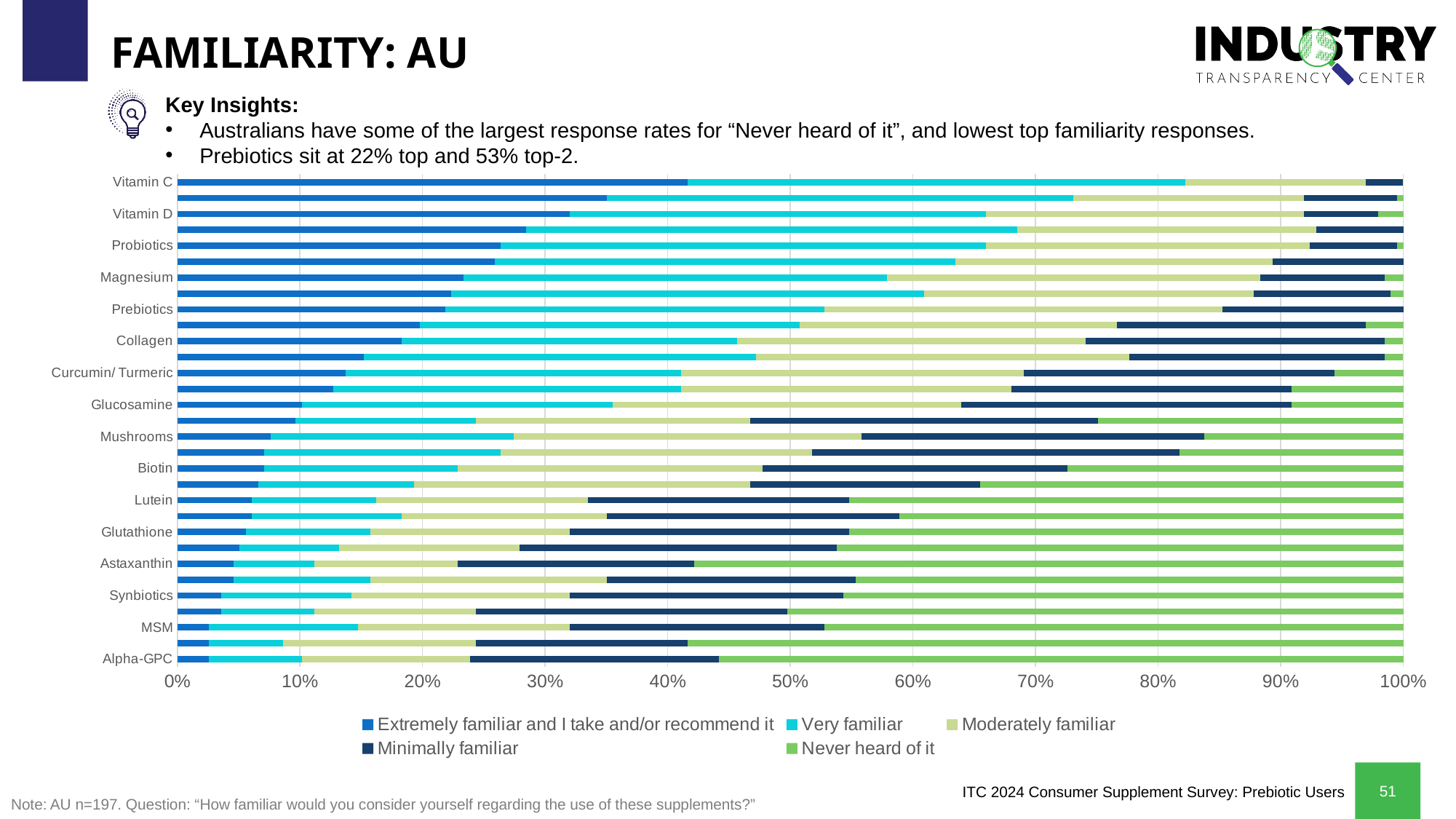
Which labelled supplement has the largest 'Never heard of it' share? Astaxanthin According to the Key Insights text, what is the top familiarity response rate for Prebiotics? 22% Is the 'Extremely familiar and I take and/or recommend it' value for Vitamin C greater or less than 30%? greater What kind of chart is shown on the slide? Stacked bar chart Is the 'Extremely familiar and I take and/or recommend it' value for Glucosamine greater or less than 20%? less Which has a larger 'Extremely familiar and I take and/or recommend it' share, Vitamin C or Prebiotics? Vitamin C How many series does the chart legend list? 5 Is the 'Never heard of it' value for Mushrooms greater or less than 20%? less Which labelled supplement has the largest 'Extremely familiar and I take and/or recommend it' share? Vitamin C Moving down the chart from Vitamin C to Alpha-GPC, does the 'Extremely familiar and I take and/or recommend it' share rise or fall? Fall Which labelled supplement has the smallest 'Never heard of it' share? Vitamin C and Prebiotics (both 0%)